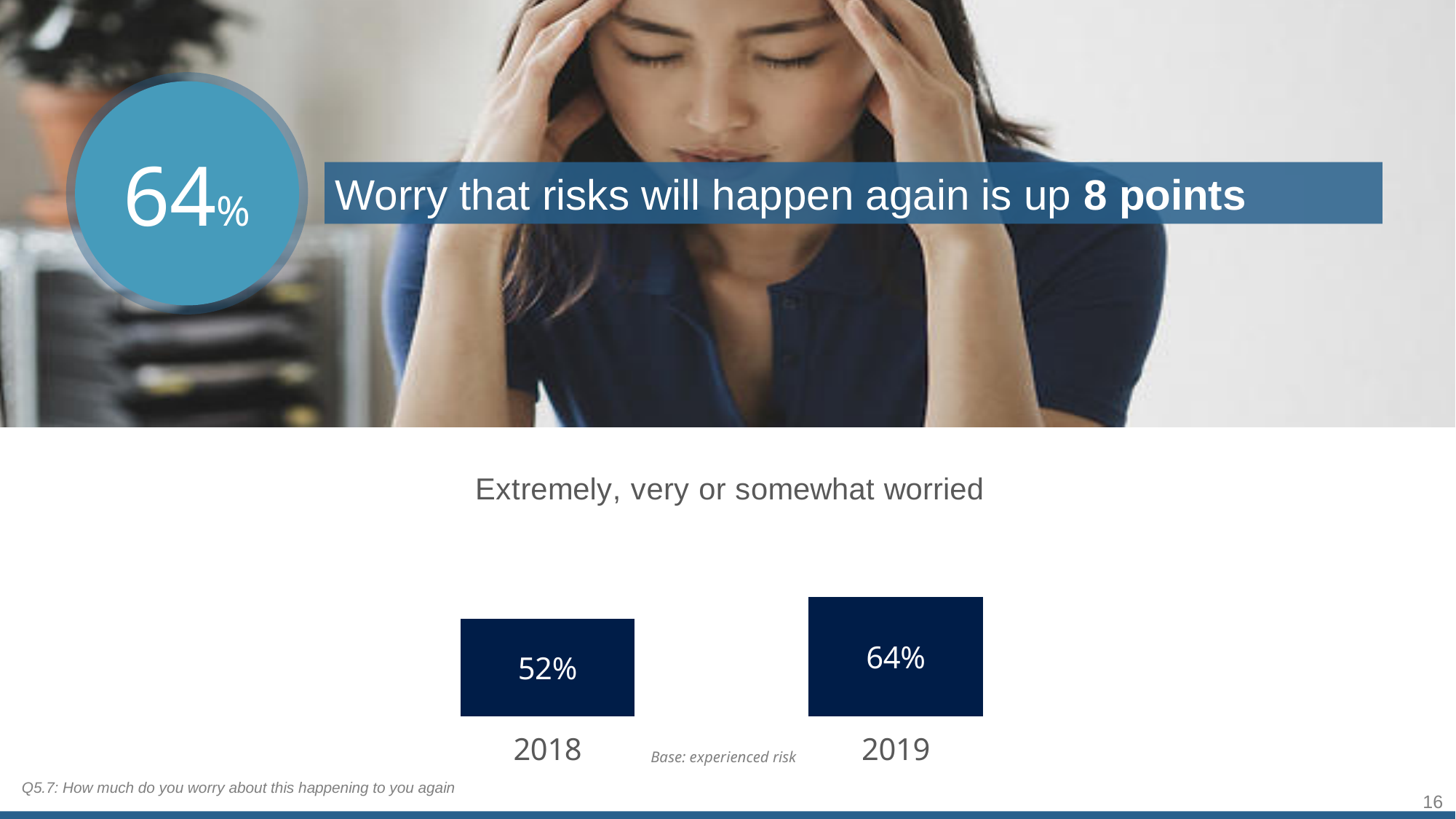
What base is noted beneath the chart? Base: experienced risk What is the difference between the 2019 and 2018 values in the chart? 12% What is the value for 2019 in the chart? 64% How many categories are shown in the chart? 2 Which year has the lower value in the chart? 2018 Do the values rise or fall from 2018 to 2019? rise What is the value for 2018 in the chart? 52% What kind of chart is shown on the slide? bar chart What is the title of the chart? Extremely, very or somewhat worried Is the value for 2019 larger or smaller than the value for 2018? larger Which year has the higher value in the chart? 2019